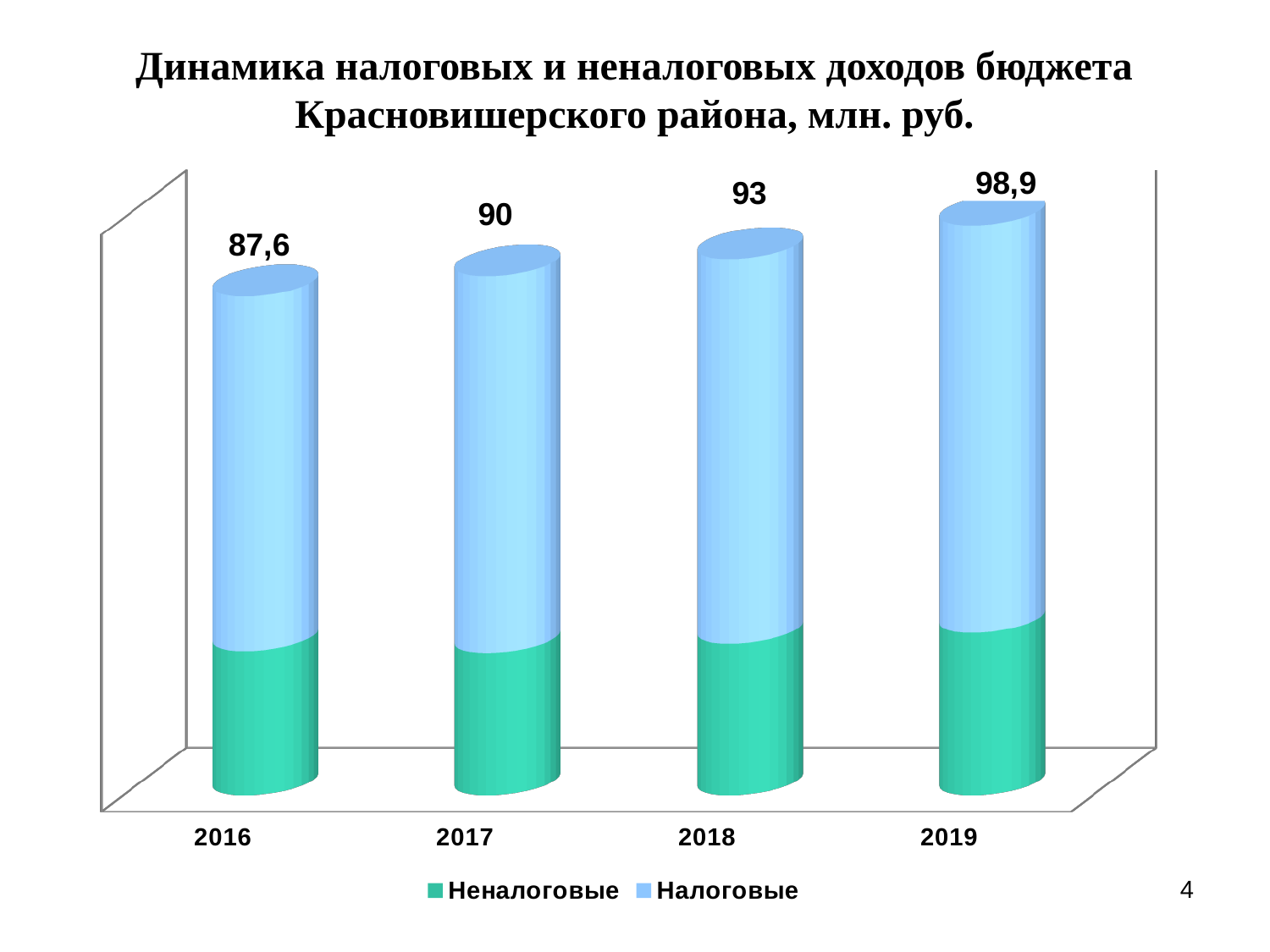
What is the difference between the total for 2019 and the total for 2016? 11,3 Which year has the highest total value? 2019 How many years are shown on the x axis? 4 What is the total value shown for 2018? 93 What is the total value shown for 2016? 87,6 How many series does the legend list? 2 Do the total values rise or fall from 2016 to 2019? rise What is the total value shown for 2017? 90 What is the difference between the total for 2018 and the total for 2017? 3 Which year has the lowest total value? 2016 What is the total value shown for 2019? 98,9 Which is larger, the total for 2017 or the total for 2018? 2018